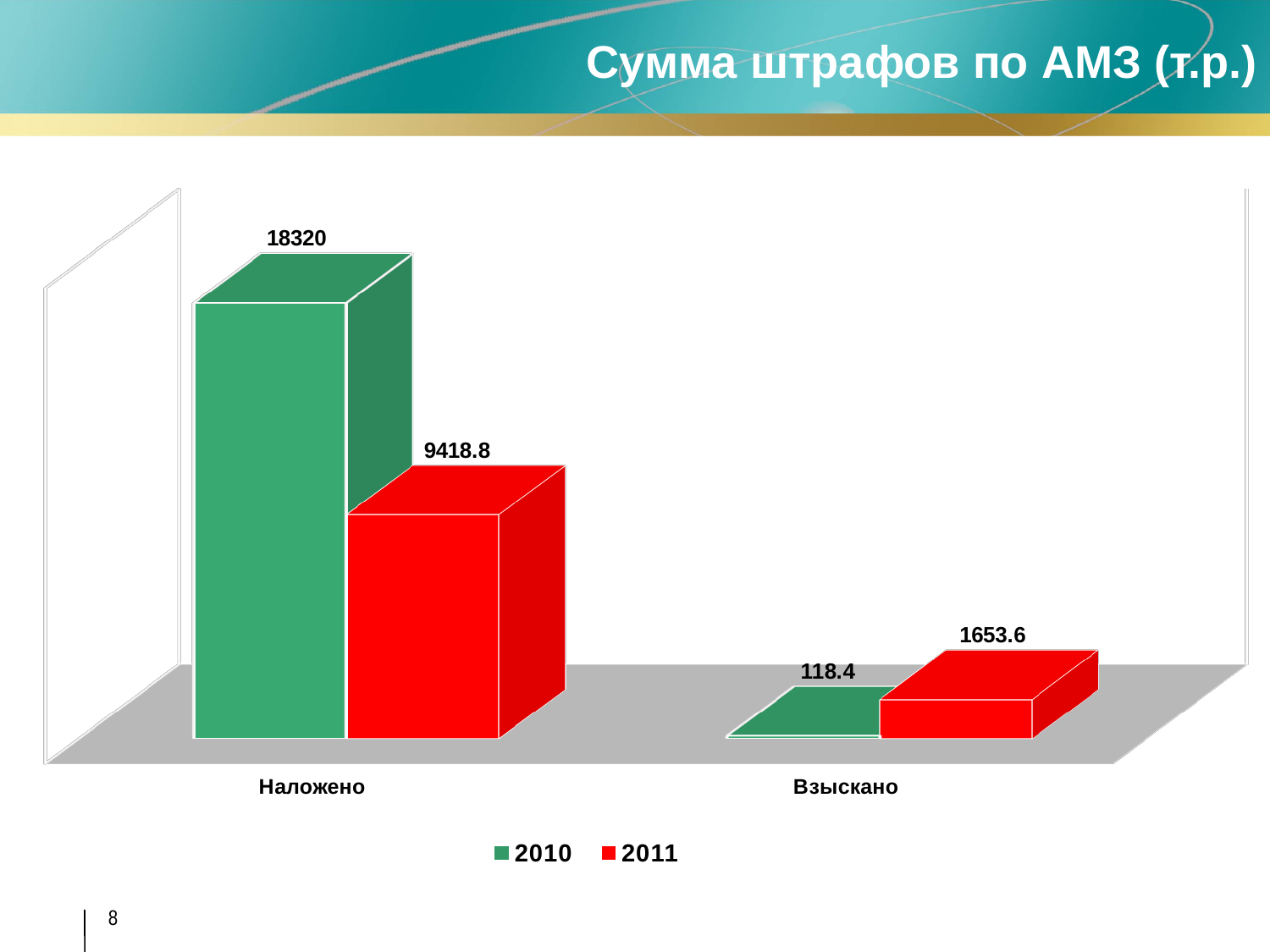
Which series has the higher value in the Наложено category, 2010 or 2011? 2010 How many series does the legend list? 2 Which bar has the lowest value on the chart? 2010 in Взыскано (118.4) Which series has the higher value in the Взыскано category, 2010 or 2011? 2011 What is the value for 2011 in the Наложено category? 9418.8 What is the value for 2010 in the Взыскано category? 118.4 What is the difference between the 2011 and 2010 values in the Взыскано category? 1535.2 What is the value for 2011 in the Взыскано category? 1653.6 What is the value for 2010 in the Наложено category? 18320 What type of chart is shown on the slide? Bar chart How many categories are shown on the x axis? 2 What is the difference between the 2010 and 2011 values in the Наложено category? 8901.2